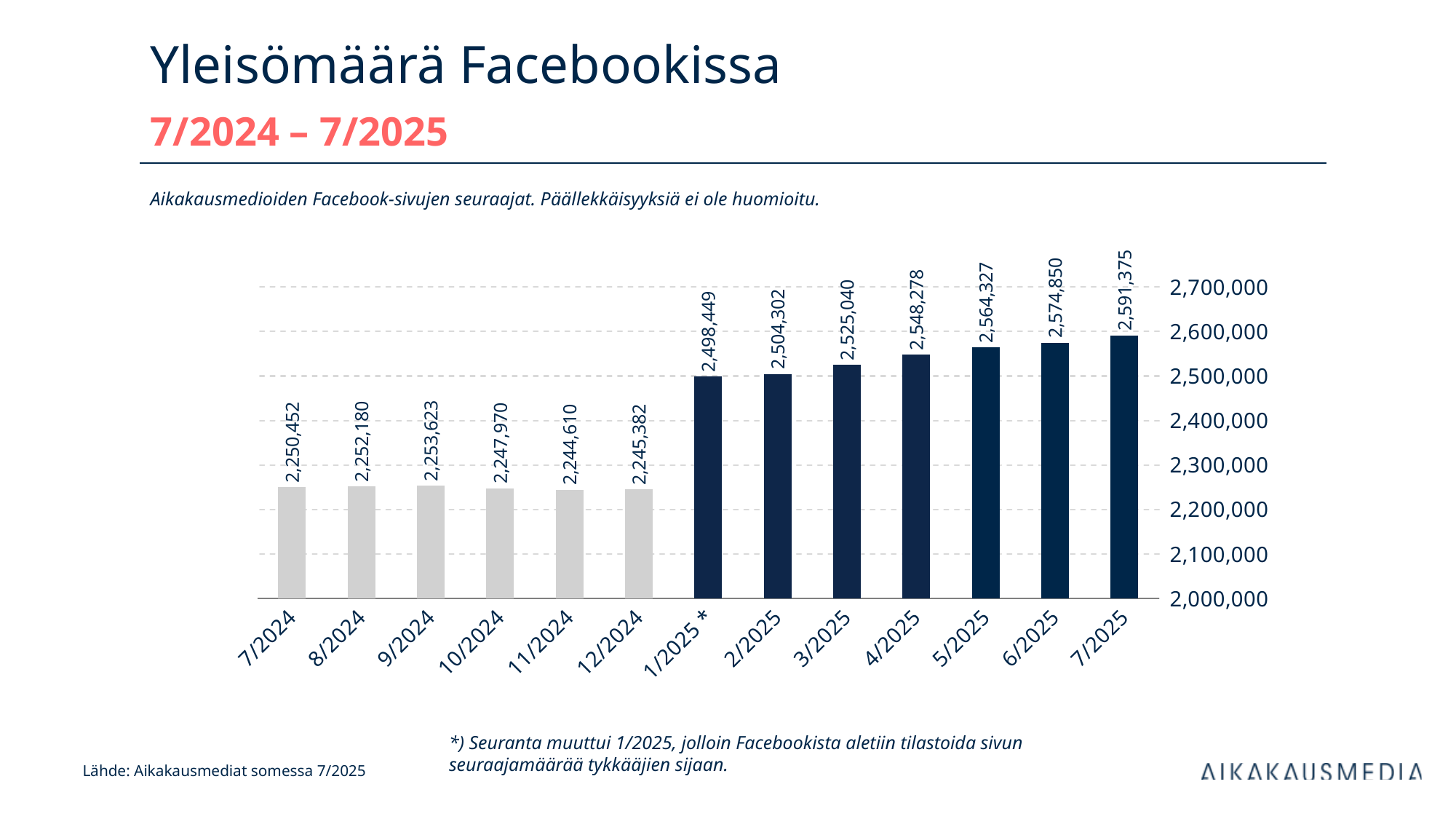
What is the value for 7/2025? 2,591,375 Which month has the highest value? 7/2025 What is the value for 7/2024? 2,250,452 What is the difference between the values for 7/2025 and 6/2025? 16,525 Do the values rise or fall from 1/2025 * to 7/2025? Rise How many months are shown on the x axis? 13 What is the value for 11/2024? 2,244,610 What is the value for 1/2025 *? 2,498,449 What kind of chart is shown on the slide? Bar chart Which month has the lowest value? 11/2024 What is the difference between the values for 1/2025 * and 12/2024? 253,067 Which is larger, the value for 3/2025 or the value for 9/2024? 3/2025